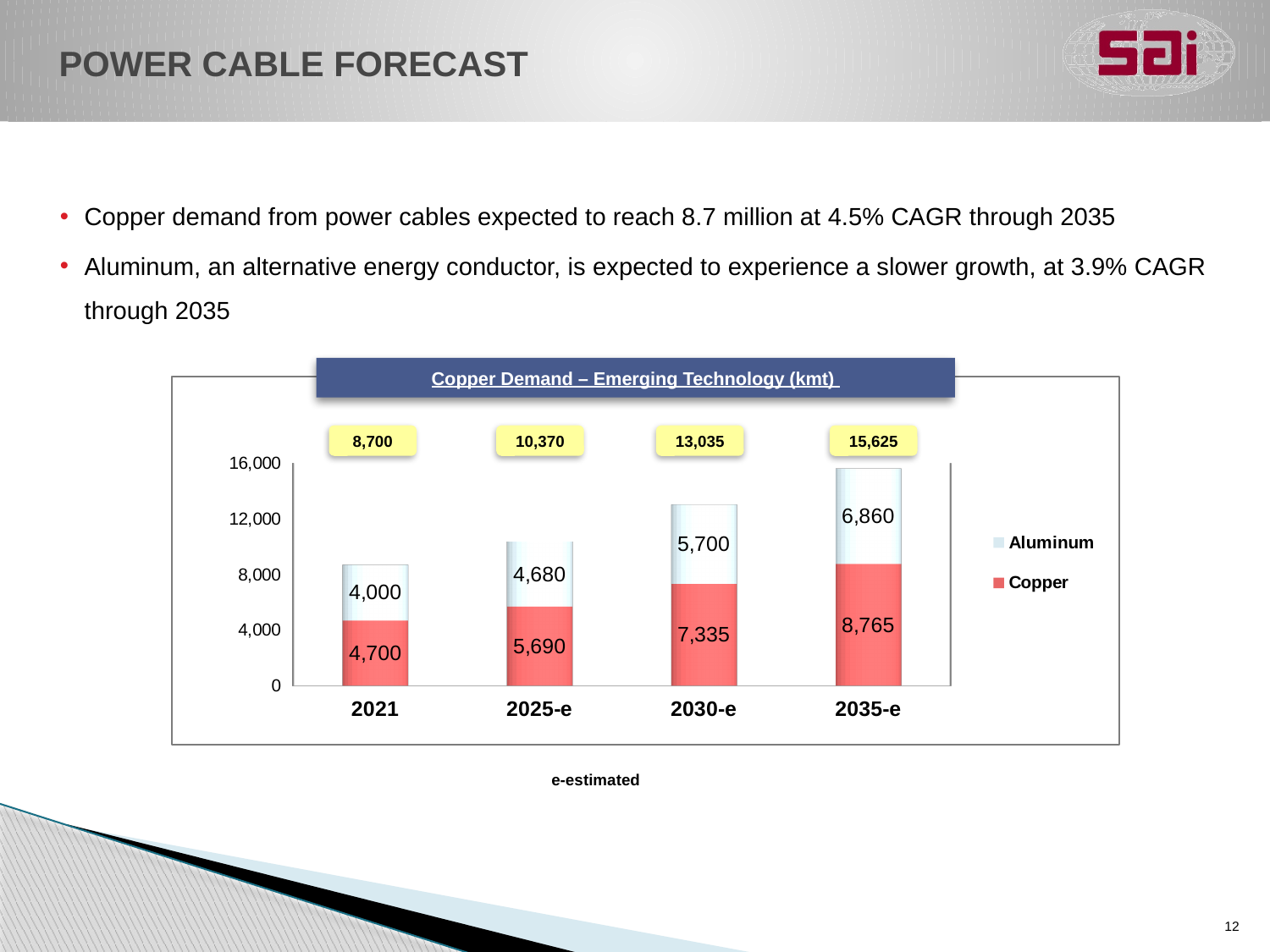
What is the Aluminum value for 2035-e? 6,860 What is the difference between the Copper value for 2035-e and the Copper value for 2021? 4,065 What kind of chart is shown? Stacked bar chart What is the Copper value for 2030-e? 7,335 How many series does the legend list? 2 How many years are shown on the x axis? 4 What is the Copper value for 2021? 4,700 Which year has the lowest Aluminum value? 2021 What is the total of the stacked bar for 2025-e? 10,370 What is the total of the stacked bar for 2035-e? 15,625 Which is larger in 2030-e, Copper or Aluminum? Copper Which year has the highest Copper value? 2035-e